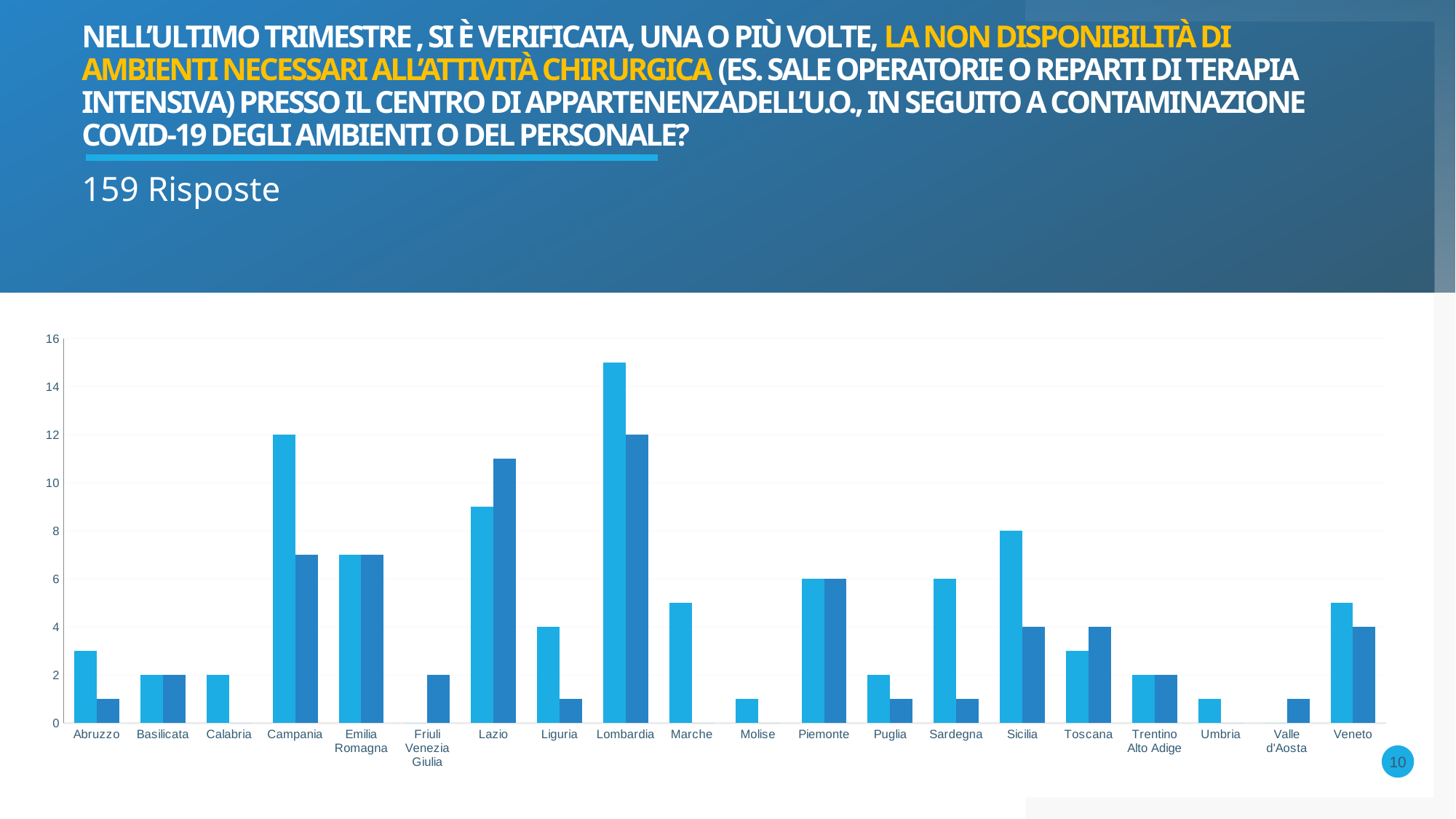
What is the value of the light blue bar for Sicilia? 8 What is the value of the light blue bar for Campania? 12 Is the value of the dark blue bar for Lazio greater or less than 10? greater What is the difference between the light blue bar for Campania and the light blue bar for Sicilia? 4 How many regions (categories) are shown on the x axis of the chart? 20 For Campania, which bar is larger, the light blue one or the dark blue one? the light blue one What kind of chart is shown on the slide? bar chart What is the value of the dark blue bar for Piemonte? 6 Which region has the tallest bar in the chart? Lombardia Is the value of the light blue bar for Lombardia greater or less than 14? greater How many responses does the slide say were collected? 159 Risposte What is the value of the dark blue bar for Lombardia? 12